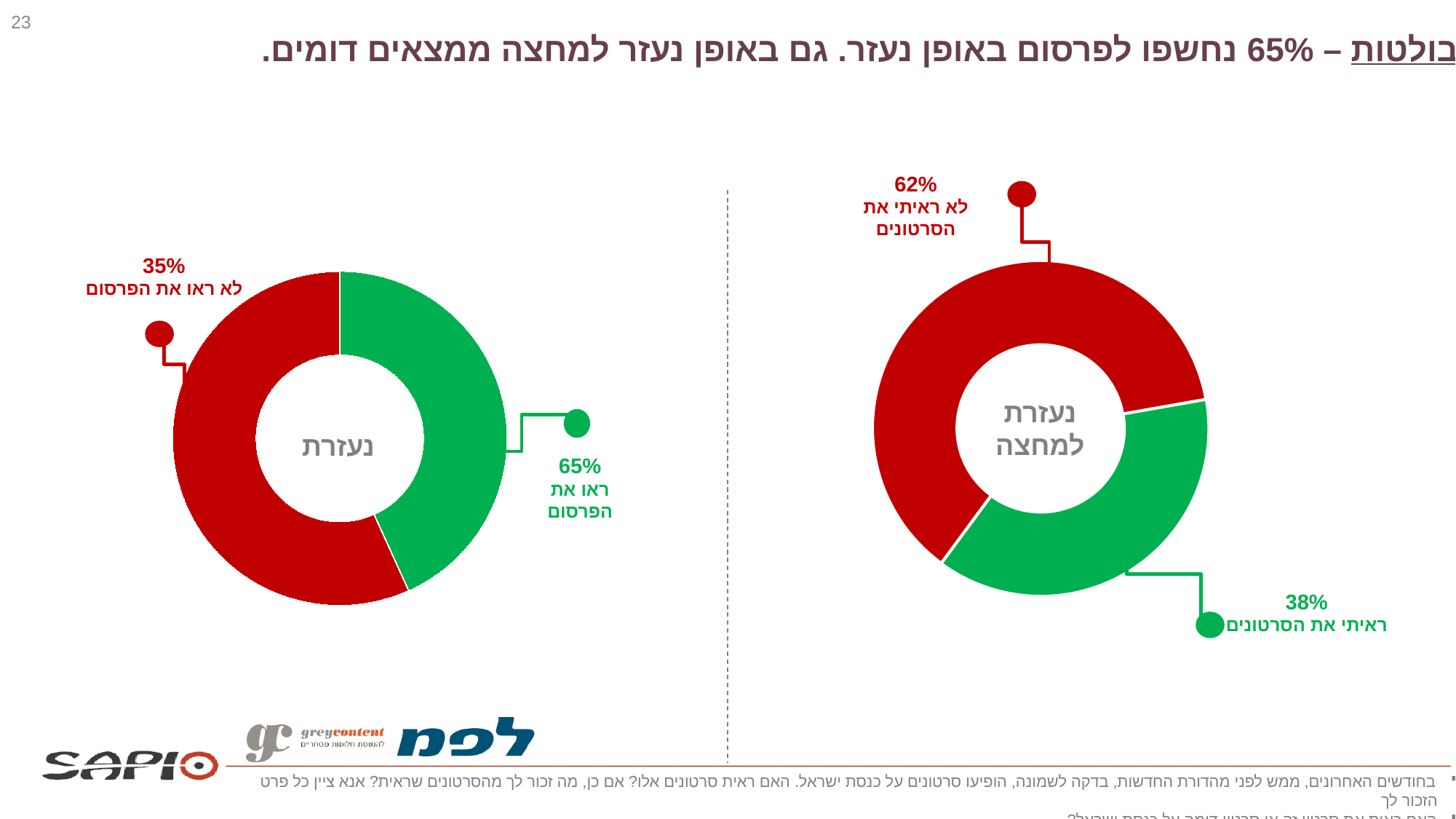
In the left chart (נעזרת), what percentage of respondents ראו את הפרסום? 65% In the right chart (נעזרת למחצה), what percentage of respondents answered לא ראיתי את הסרטונים? 62% In the right chart (נעזרת למחצה), which slice is the smallest? ראיתי את הסרטונים In the right chart (נעזרת למחצה), what percentage of respondents answered ראיתי את הסרטונים? 38% What type of chart is used on the left side of the slide? Donut (pie) chart In the right chart (נעזרת למחצה), what colour is the slice for לא ראיתי את הסרטונים? Red In the left chart (נעזרת), what is the difference in percentage points between ראו את הפרסום and לא ראו את הפרסום? 30 Which is larger: the share of ראו את הפרסום in the left chart or the share of ראיתי את הסרטונים in the right chart? ראו את הפרסום in the left chart In the left chart (נעזרת), what percentage of respondents לא ראו את הפרסום? 35% In the right chart (נעזרת למחצה), what is the difference in percentage points between לא ראיתי את הסרטונים and ראיתי את הסרטונים? 24 How many slices does the right chart (נעזרת למחצה) have? 2